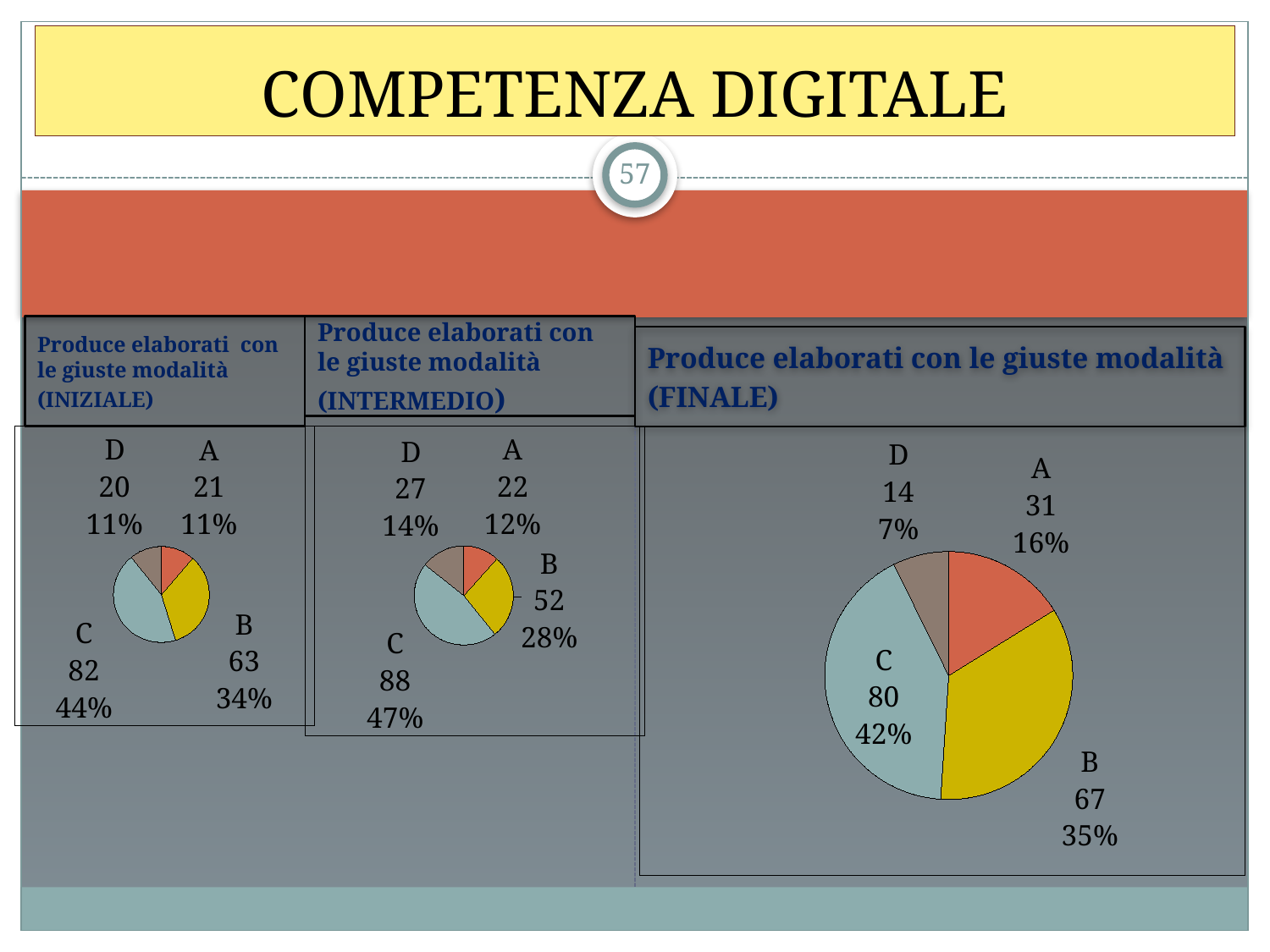
In the INTERMEDIO pie chart, what share of the pie does category D represent? 14% How many categories does the FINALE pie chart show? 4 In the FINALE pie chart, which category has the lowest value? D What type of chart is used for the INIZIALE data? Pie chart In the FINALE pie chart, what is the difference between the values for C and B? 13 In the INIZIALE pie chart, what share of the pie does category B represent? 34% In the FINALE pie chart, what is the value for category A? 31 In the INTERMEDIO pie chart, which category has the highest value? C What is the title of the chart on the right of the slide? Produce elaborati con le giuste modalità (FINALE) In the INTERMEDIO pie chart, what is the value for category B? 52 In the FINALE pie chart, which is larger, the value for A or the value for D? A In the INIZIALE pie chart, what is the value for category C? 82